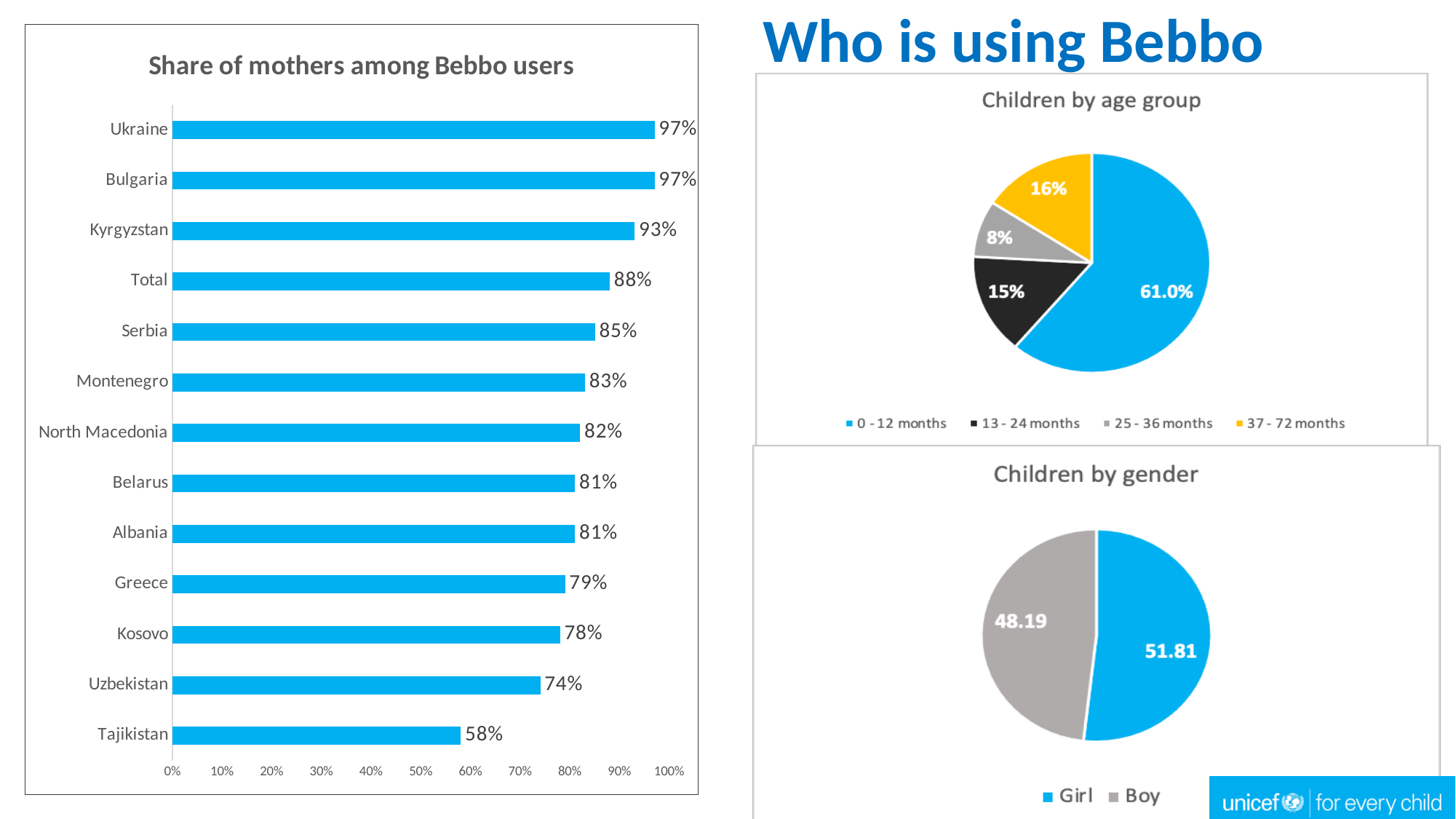
In the 'Share of mothers among Bebbo users' chart, which country has the lowest share? Tajikistan In the 'Children by age group' chart, what share is 13 - 24 months? 15% In the 'Share of mothers among Bebbo users' chart, which is larger, Greece or Uzbekistan? Greece In the 'Children by age group' chart, which age group has the largest slice? 0 - 12 months What kind of chart is 'Share of mothers among Bebbo users'? Bar chart In the 'Share of mothers among Bebbo users' chart, what is the value for Kyrgyzstan? 93% In the 'Share of mothers among Bebbo users' chart, what is the difference between Serbia and Kosovo? 7% In the 'Share of mothers among Bebbo users' chart, how many bars are plotted? 13 In the 'Share of mothers among Bebbo users' chart, what is the value for Total? 88% In the 'Children by gender' chart, which colour represents Boy? Grey How many series does the legend of the 'Children by age group' chart list? 4 In the 'Children by gender' chart, what is the value for Girl? 51.81